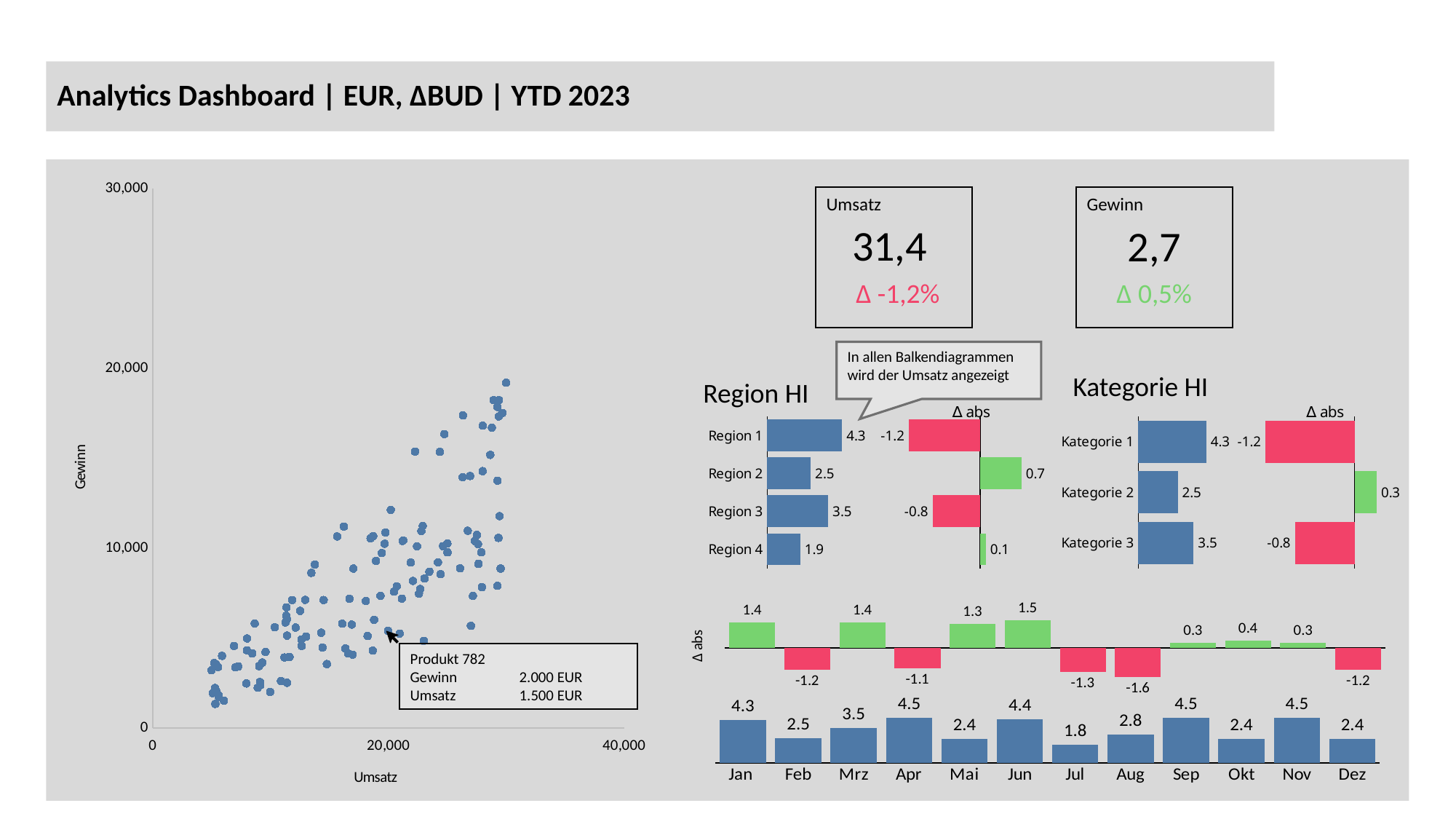
In the monthly Δ abs chart at the bottom right, which month has the lowest Δ abs value? Aug What kind of chart is the large chart on the left of the slide? Scatter plot In the Region HI chart, what is the Umsatz value for Region 3? 3.5 In the monthly bar chart at the bottom right, which month has the lowest Umsatz? Jul In the scatter plot on the left, what is the Gewinn shown in the tooltip for Produkt 782? 2.000 EUR In the monthly bar chart at the bottom right, what is the Umsatz value for Jun? 4.4 In the monthly bar chart at the bottom right, is the Umsatz for Apr or for Mai larger? Apr In the Region HI chart, what is the Δ abs value for Region 2? 0.7 In the Region HI chart, what is the difference in Umsatz between Region 1 and Region 4? 2.4 In the Kategorie HI chart, how many categories are shown? 3 In the Kategorie HI chart, what is the Δ abs value for Kategorie 2? 0.3 In the Region HI chart, which region has the lowest Umsatz? Region 4